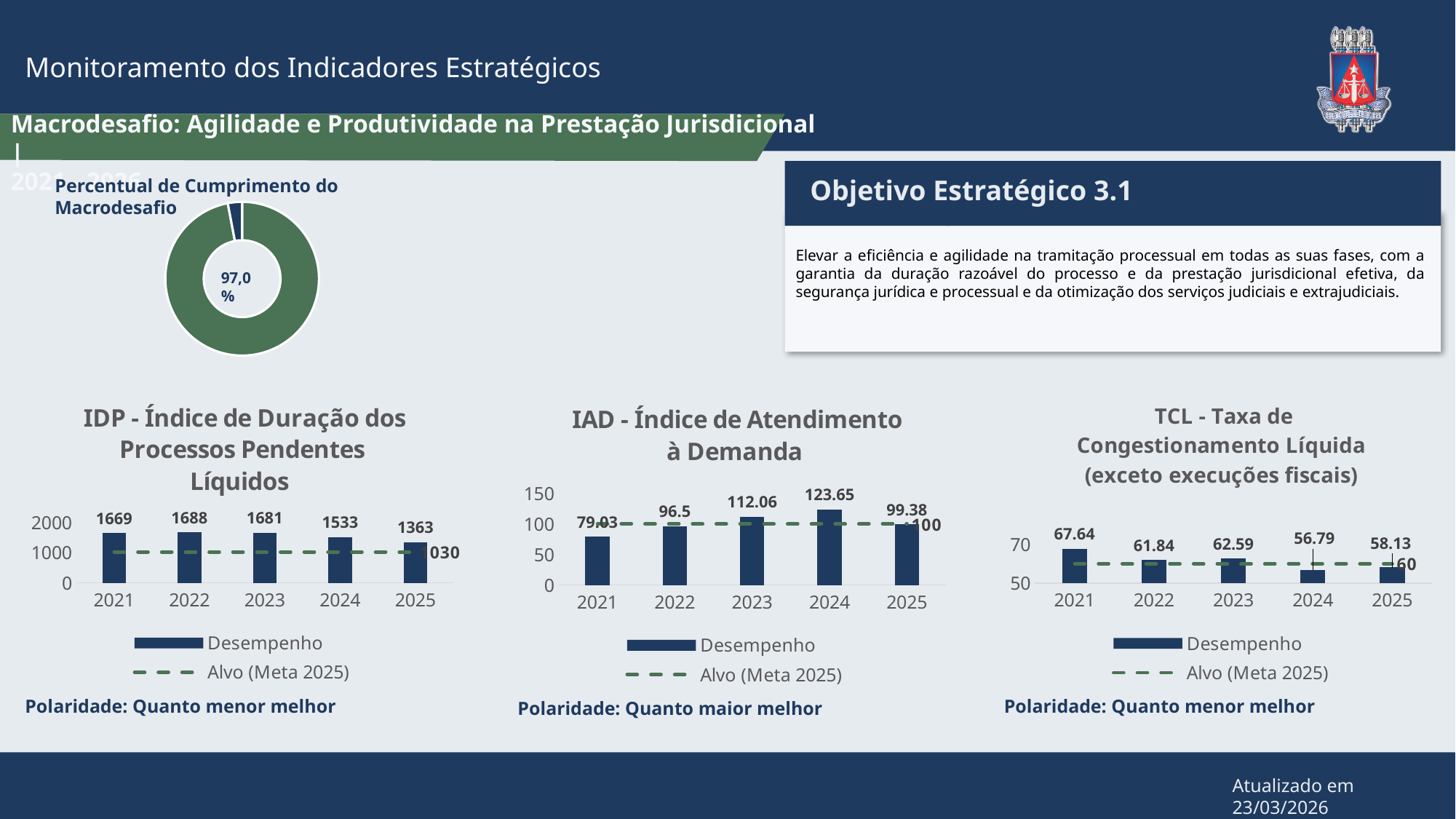
In the IAD - Índice de Atendimento à Demanda chart, which year has the lowest value? 2021 In the TCL - Taxa de Congestionamento Líquida chart, which year has the lowest value? 2024 In the TCL - Taxa de Congestionamento Líquida chart, is the 2021 value larger or smaller than the 2022 value? larger In the TCL - Taxa de Congestionamento Líquida chart, what is the value for 2023? 62.59 What percentage is shown in the centre of the Percentual de Cumprimento do Macrodesafio donut chart? 97,0% In the IAD - Índice de Atendimento à Demanda chart, what is the value for 2024? 123.65 How many years are shown on the x axis of the IAD - Índice de Atendimento à Demanda chart? 5 How many entries does the legend of the IDP - Índice de Duração dos Processos Pendentes Líquidos chart list? 2 In the IDP - Índice de Duração dos Processos Pendentes Líquidos chart, what is the difference between the 2021 and 2025 values? 306 In the IDP - Índice de Duração dos Processos Pendentes Líquidos chart, which year has the highest Desempenho value? 2022 In the IDP - Índice de Duração dos Processos Pendentes Líquidos chart, what is the Desempenho value for 2025? 1363 In the IAD - Índice de Atendimento à Demanda chart, what is the Alvo (Meta 2025) value? 100